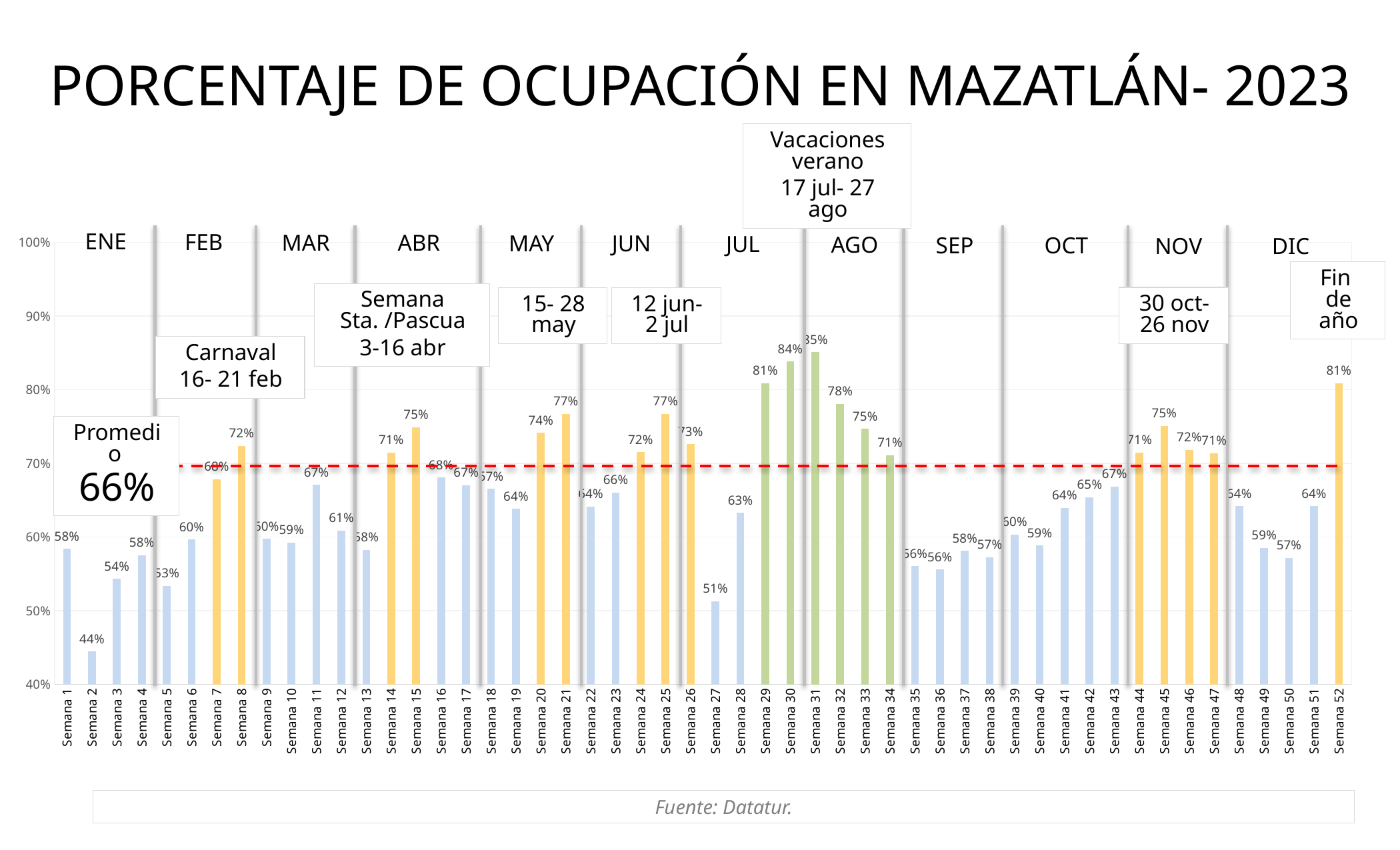
What kind of chart is shown on the slide? bar chart Which week has the lowest occupancy percentage? Semana 2 What average (Promedio) value is shown on the chart? 66% Is the value for Semana 27 greater or less than 60%? less What is the occupancy percentage for Semana 2? 44% Do the values rise or fall from Semana 29 to Semana 31? rise What is the occupancy percentage for Semana 31? 85% How many weeks are plotted on the chart? 52 Which is larger, the occupancy for Semana 15 or Semana 21? Semana 21 Which week has the highest occupancy percentage? Semana 31 What is the occupancy percentage for Semana 52? 81% What is the difference between the occupancy for Semana 31 and Semana 2? 41%